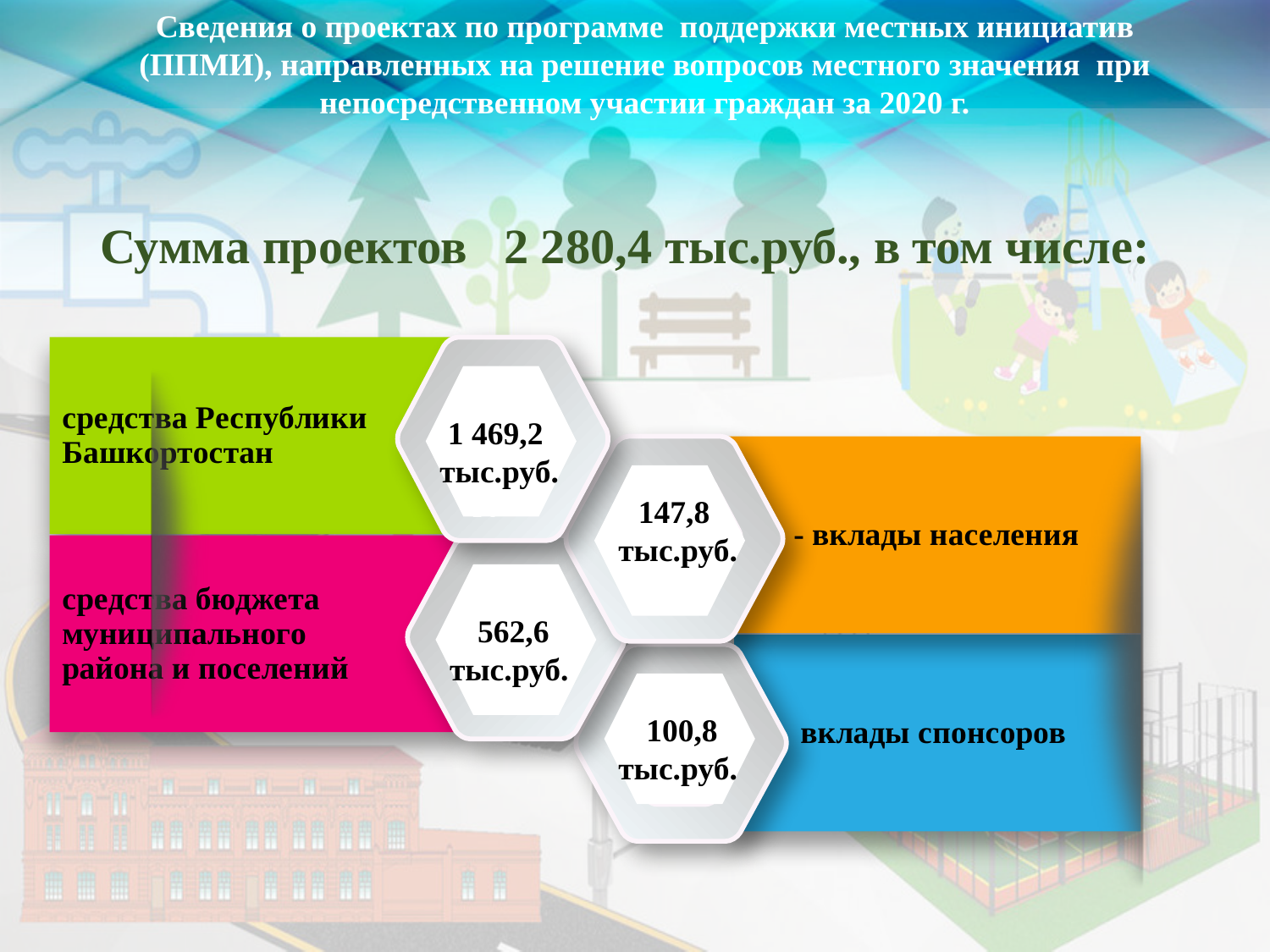
What amount is shown for вклады спонсоров? 100,8 тыс.руб. Which funding source has the smallest amount? вклады спонсоров How many funding sources are listed in the diagram? 4 Which funding source has the largest amount? средства Республики Башкортостан What amount is shown for вклады населения? 147,8 тыс.руб. What is the total sum of projects shown on the slide? 2 280,4 тыс.руб. What amount is shown for средства Республики Башкортостан? 1 469,2 тыс.руб. Which is larger: средства бюджета муниципального района и поселений or вклады населения? средства бюджета муниципального района и поселений What colour is the block for вклады спонсоров? blue What amount is shown for средства бюджета муниципального района и поселений? 562,6 тыс.руб. What is the difference between средства Республики Башкортостан and средства бюджета муниципального района и поселений? 906,6 тыс.руб. What is the difference between вклады населения and вклады спонсоров? 47,0 тыс.руб.